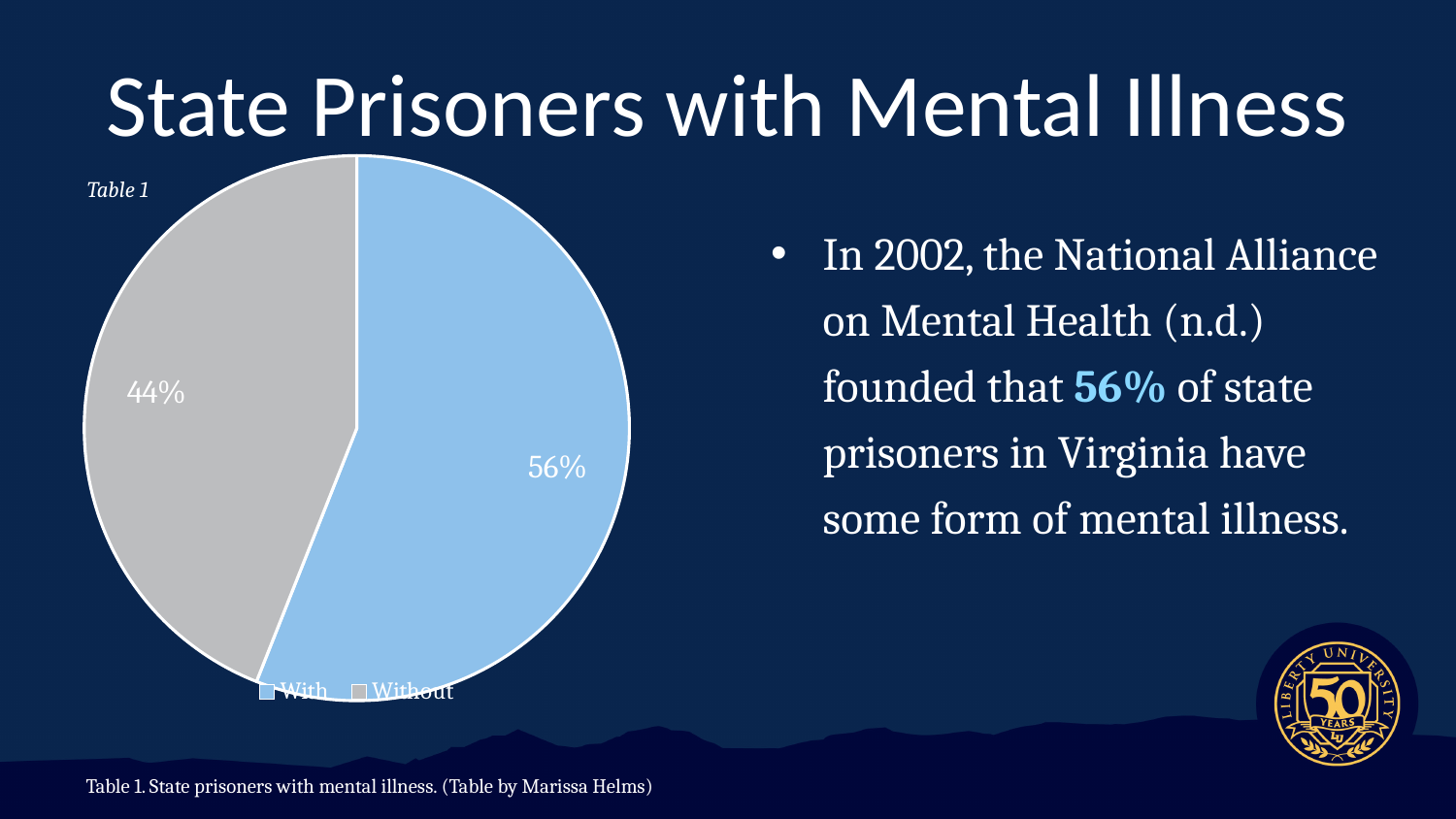
Which slice of the pie is the smallest? Without What share of the pie does the "With" slice represent? 56% Which slice of the pie is the largest? With What is the difference in percentage points between the "With" and "Without" slices? 12 What percentage of the pie is labelled "Without"? 44% What label appears in the top-left corner of the chart? Table 1 How many slices does the pie chart have? 2 What colour is the "Without" slice? grey Which slice is larger, "With" or "Without"? With What percentage of the pie is labelled "With"? 56% How many entries does the legend list? 2 What kind of chart is shown on the slide? pie chart